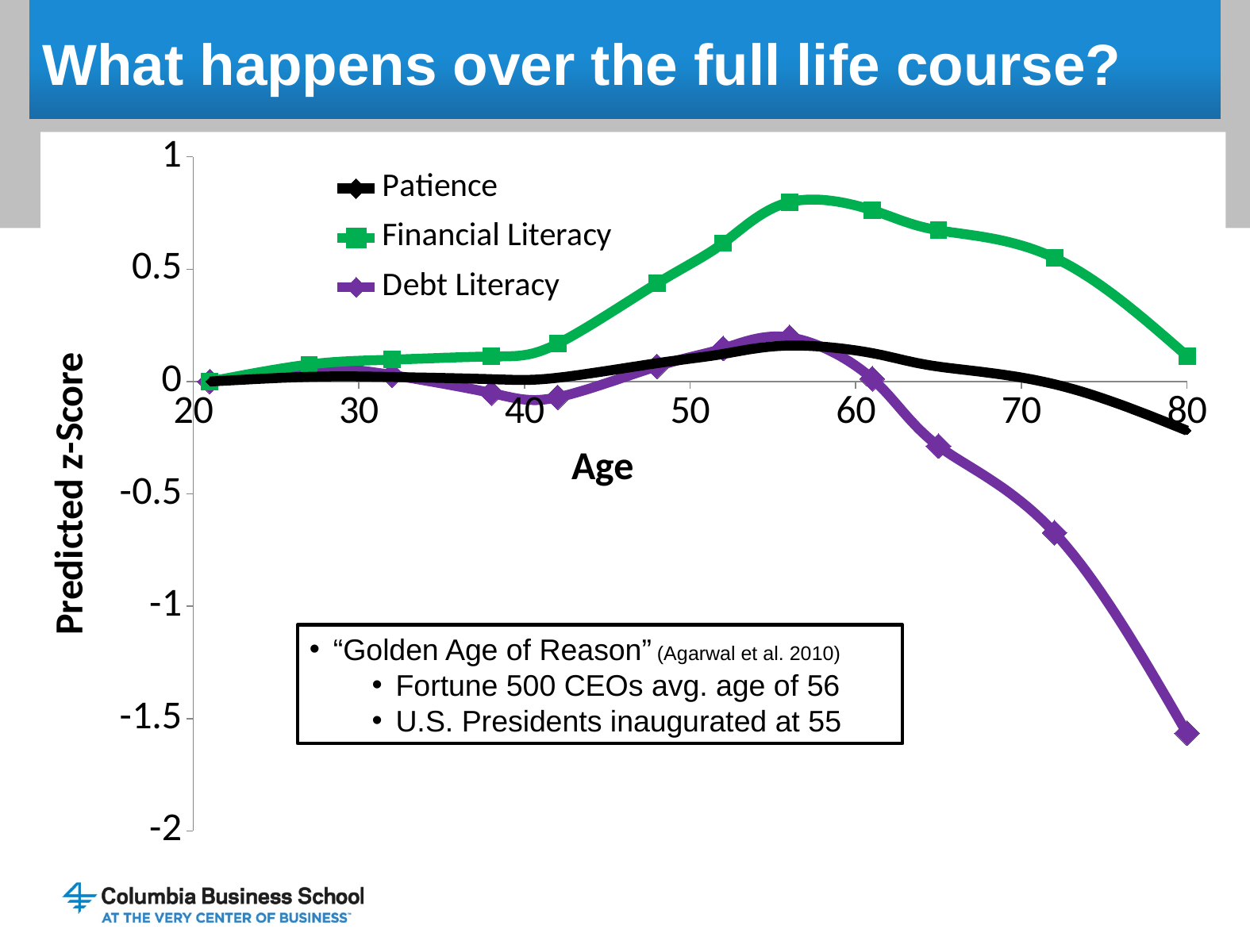
Is the Financial Literacy value at age 56 greater or less than 0.5? greater How many series does the legend list? 3 Does the Financial Literacy line rise or fall between age 20 and age 56? rise What are the three series named in the legend? Patience, Financial Literacy, Debt Literacy Is the Patience value at age 80 greater or less than -0.5? greater At age 80, which series has the higher value, Financial Literacy or Debt Literacy? Financial Literacy Is the Debt Literacy value at age 80 greater or less than -1? less What kind of chart is shown on the slide? line chart Does the Debt Literacy line rise or fall between age 60 and age 80? fall What is the title of the vertical axis? Predicted z-Score Which series reaches the highest value anywhere on the chart? Financial Literacy Which series reaches the lowest value anywhere on the chart? Debt Literacy